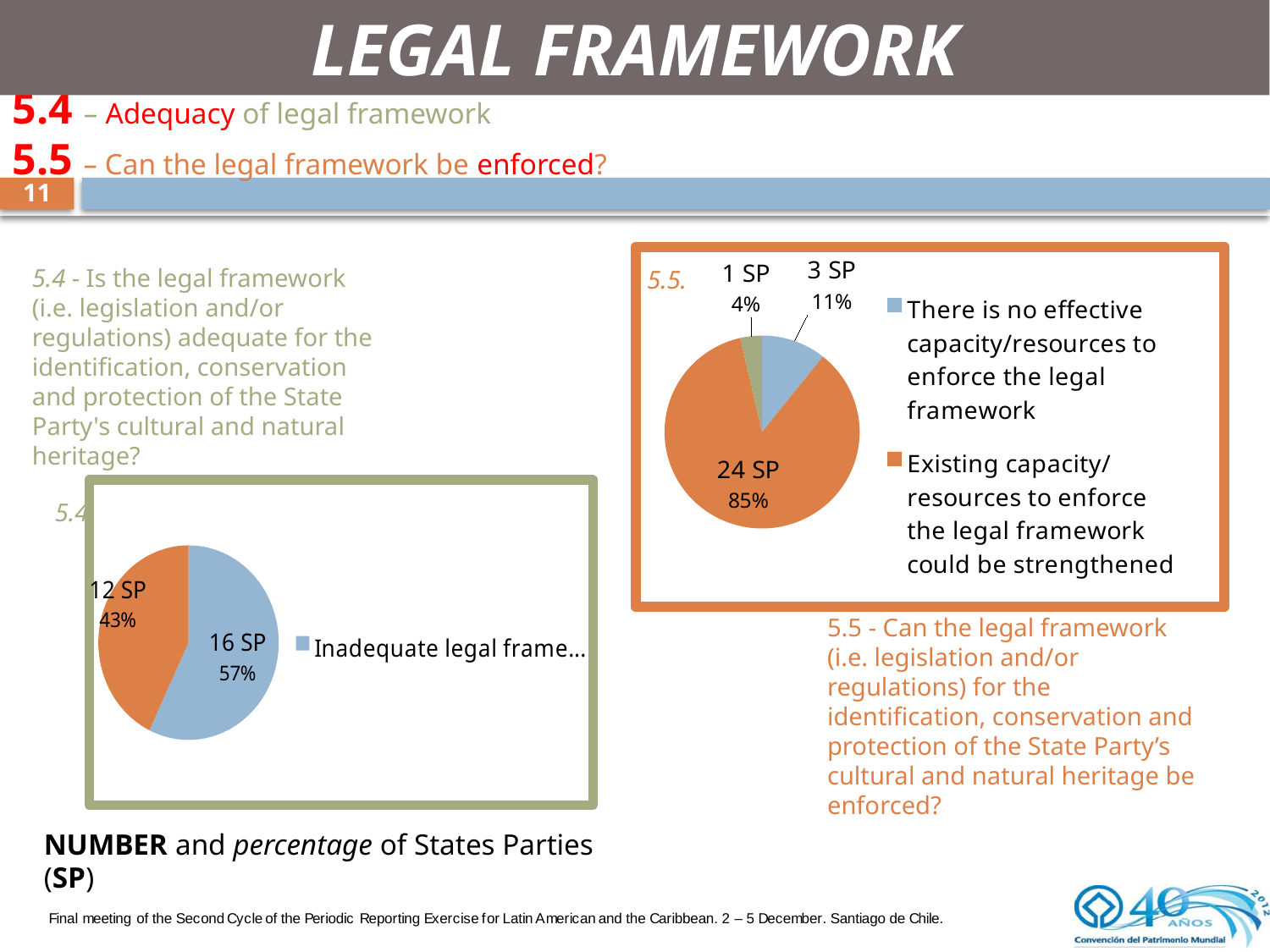
In the 5.5 pie chart on the right, what percentage share does the slice for 'There is no effective capacity/resources to enforce the legal framework' have? 11% In the 5.5 pie chart on the right, what is the smallest slice's value? 1 SP In the 5.4 pie chart on the left, how many States Parties are in the blue slice labelled 'Inadequate legal frame...'? 16 SP What kind of chart is the 5.5 chart on the right of the slide? pie chart What kind of chart is the 5.4 chart on the left of the slide? pie chart In the 5.5 pie chart on the right, how many entries does the legend list? 2 In the 5.5 pie chart on the right, what percentage share does the largest slice have? 85% In the 5.5 pie chart on the right, what is the total number of States Parties across all three slices? 28 SP In the 5.5 pie chart on the right, how many slices does the pie have? 3 In the 5.5 pie chart on the right, how many States Parties are in the slice for 'Existing capacity/resources to enforce the legal framework could be strengthened'? 24 SP In the 5.4 pie chart on the left, what is the difference in States Parties between the 16 SP slice and the 12 SP slice? 4 SP In the 5.4 pie chart on the left, which slice is larger: the blue slice or the orange slice? the blue slice